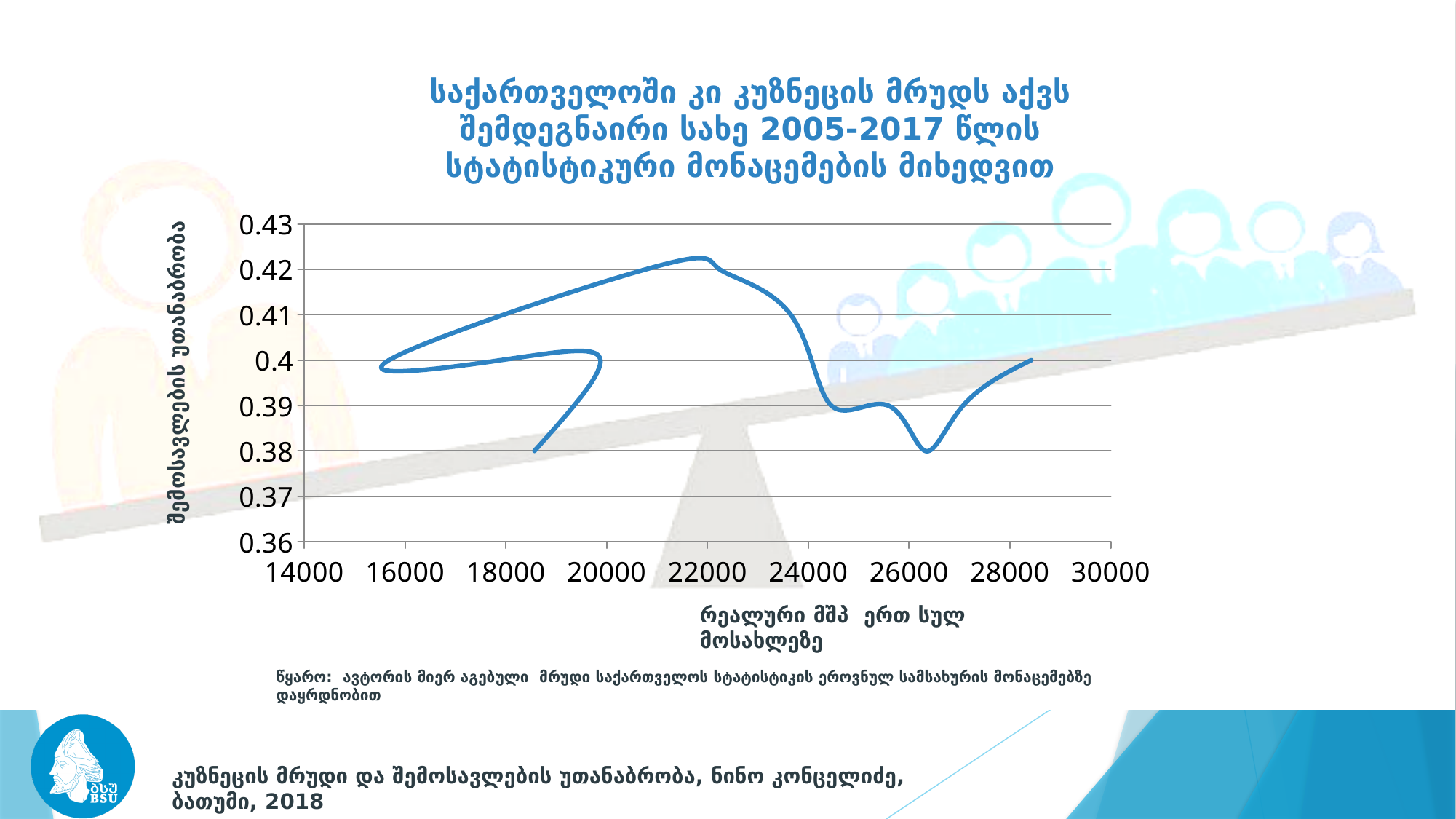
Between about 22000 and 24500 on the horizontal axis, does the curve rise or fall? fall Is the value of the curve at about 23000 on the horizontal axis greater or less than 0.40? greater Is the value of the curve at about 28000 on the horizontal axis greater or less than 0.41? less What is the lowest value shown on the horizontal axis of the chart? 14000 Between about 26500 and 28000 on the horizontal axis, does the curve rise or fall? rise Is the peak value of the curve (near 22000 on the horizontal axis) greater or less than 0.41? greater What is the highest value shown on the vertical axis of the chart? 0.43 What kind of chart is shown on the slide? line chart Which years does the chart title say the statistical data cover? 2005-2017 How many data series are plotted on the chart? 1